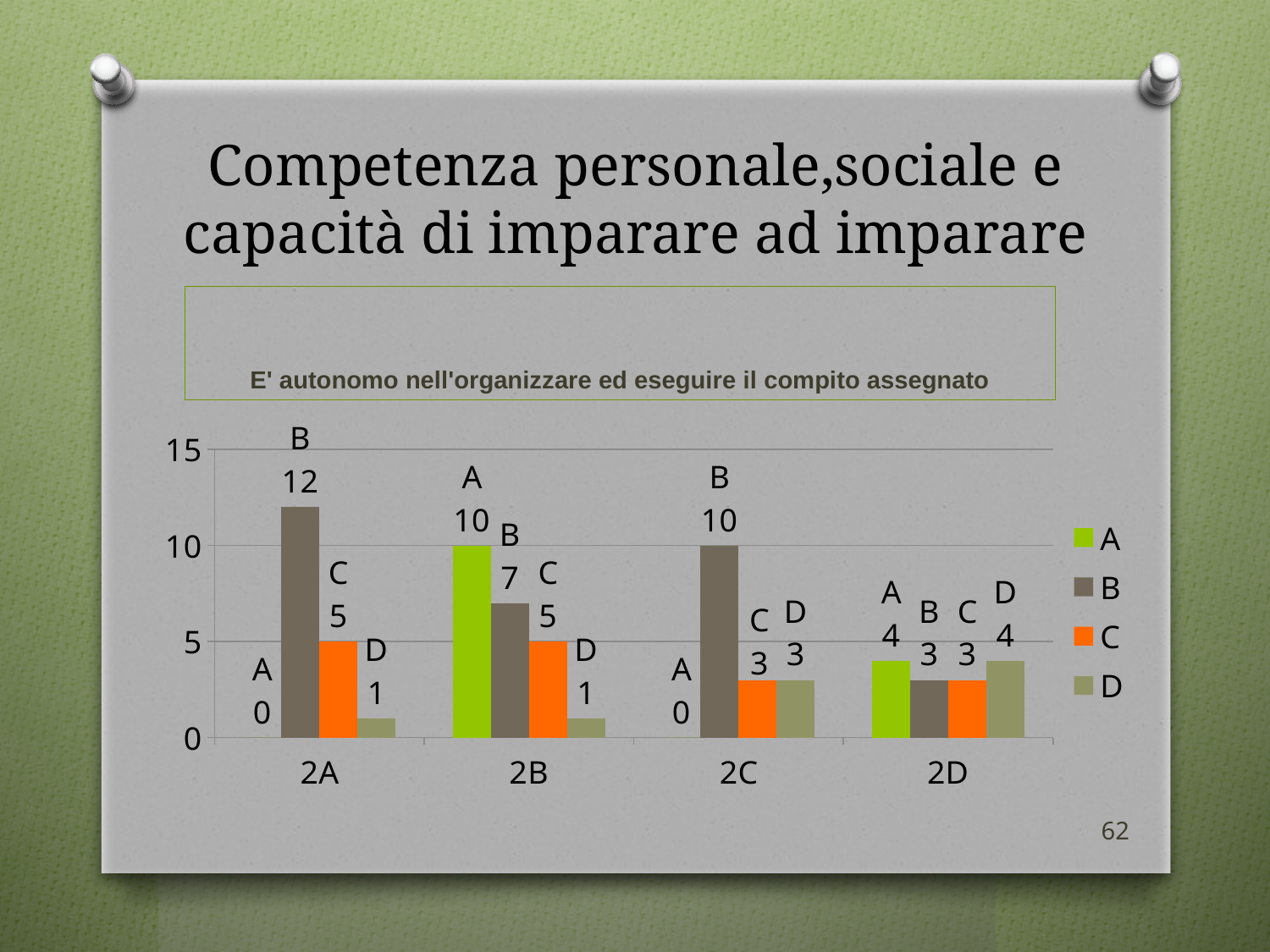
What is the difference between series B and series C for class 2A? 7 What kind of chart is shown on the slide? bar chart How many series does the legend list? 4 What is the value of series D for class 2C? 3 What is the value of series A for class 2B? 10 Which series has the highest value for class 2C? B What is the title of the chart? E' autonomo nell'organizzare ed eseguire il compito assegnato Which series has the lowest value for class 2B? D How many classes are shown on the x axis? 4 What is the value of series B for class 2A? 12 For class 2B, which is larger: series A or series B? A What is the value of series A for class 2A? 0